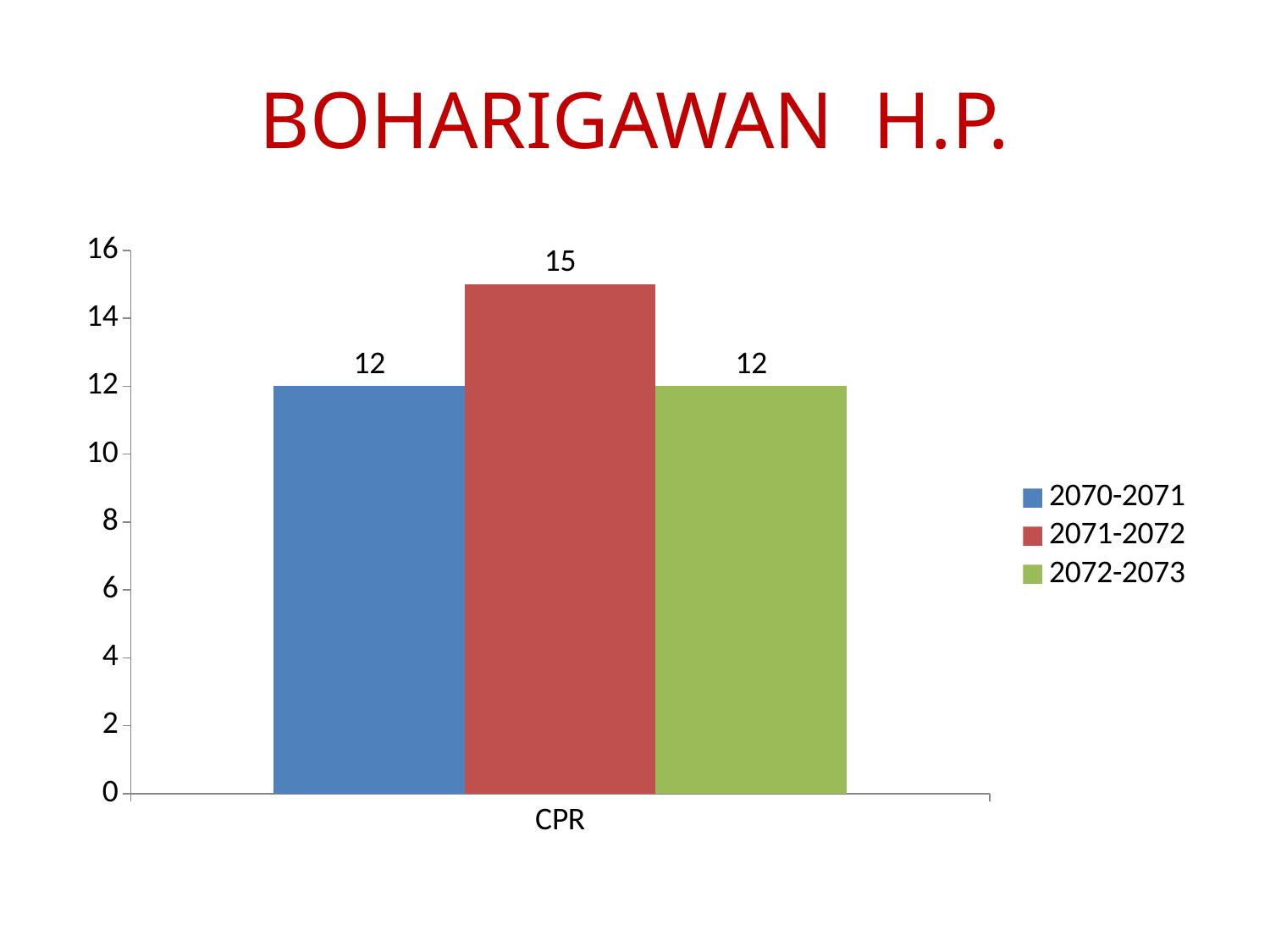
Which series has the highest CPR value? 2071-2072 What is the title of the slide? BOHARIGAWAN H.P. What is the CPR value for 2072-2073? 12 How many series does the legend list? 3 Which is larger, the CPR value for 2071-2072 or for 2072-2073? 2071-2072 Is the CPR value for 2071-2072 greater or less than 14? greater What is the difference between the CPR values for 2071-2072 and 2070-2071? 3 Is the CPR value for 2070-2071 greater or less than 10? greater What kind of chart is shown on the slide? bar chart What is the category label shown on the x axis? CPR What is the CPR value for 2071-2072? 15 What is the CPR value for 2070-2071? 12